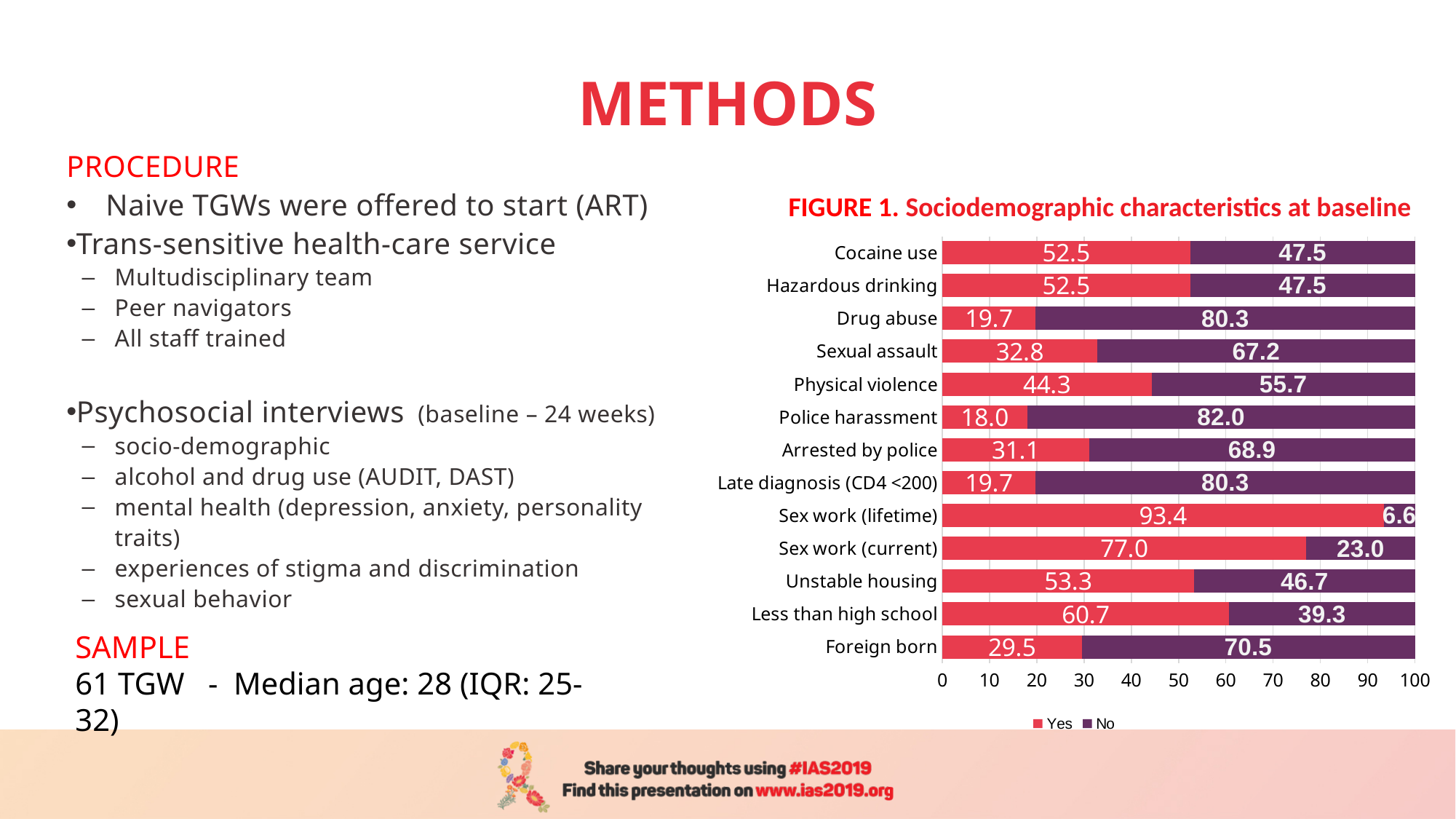
What is the 'Yes' value for Foreign born? 29.5 What is the total of the stacked bar for Less than high school? 100.0 What is the title of the figure? FIGURE 1. Sociodemographic characteristics at baseline What kind of chart is shown on the slide? Stacked bar chart What is the 'No' value for Police harassment? 82.0 How many categories are shown in the chart? 13 What is the 'Yes' value for Sex work (lifetime)? 93.4 Which category has the lowest 'Yes' value? Police harassment Which category has the highest 'Yes' value? Sex work (lifetime) What is the difference between the 'Yes' values for Sex work (current) and Unstable housing? 23.7 Which has a larger 'Yes' value, Physical violence or Sexual assault? Physical violence How many series does the legend list? 2